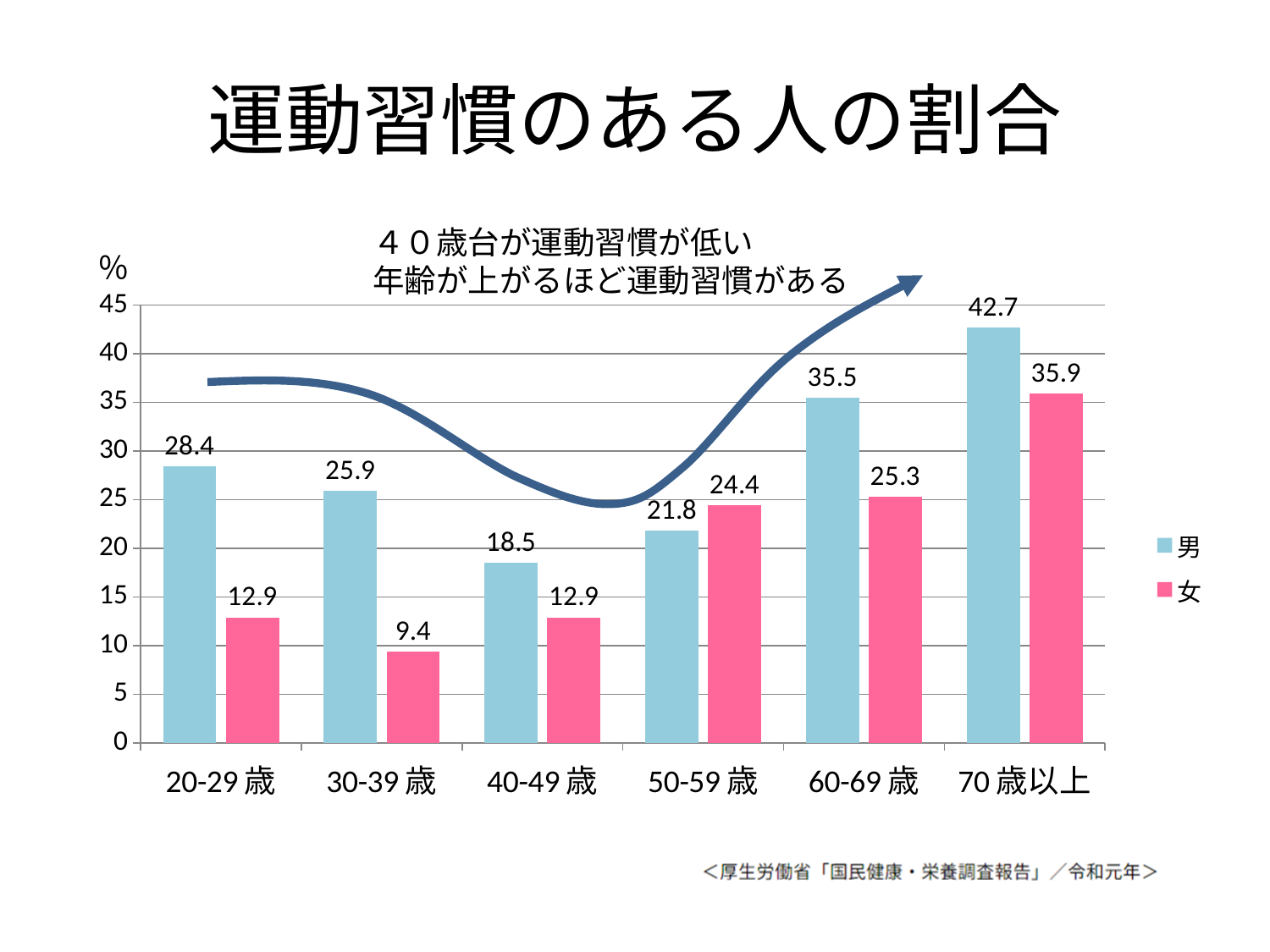
How many age groups are shown on the x axis? 6 Which age group has the lowest value for 女 (women)? 30-39歳 Which is larger in the 50-59歳 age group, the value for 男 (men) or 女 (women)? 女 What is the difference between the 男 (men) and 女 (women) values in the 20-29歳 age group? 15.5 Do the values for 男 (men) rise or fall from 50-59歳 to 70歳以上? Rise What is the value for 男 (men) in the 40-49歳 age group? 18.5 How many series does the legend list? 2 What is the value for 女 (women) in the 70歳以上 age group? 35.9 What is the title of the slide? 運動習慣のある人の割合 Which age group has the highest value for 男 (men)? 70歳以上 What kind of chart is shown on the slide? Bar chart What is the value for 女 (women) in the 30-39歳 age group? 9.4